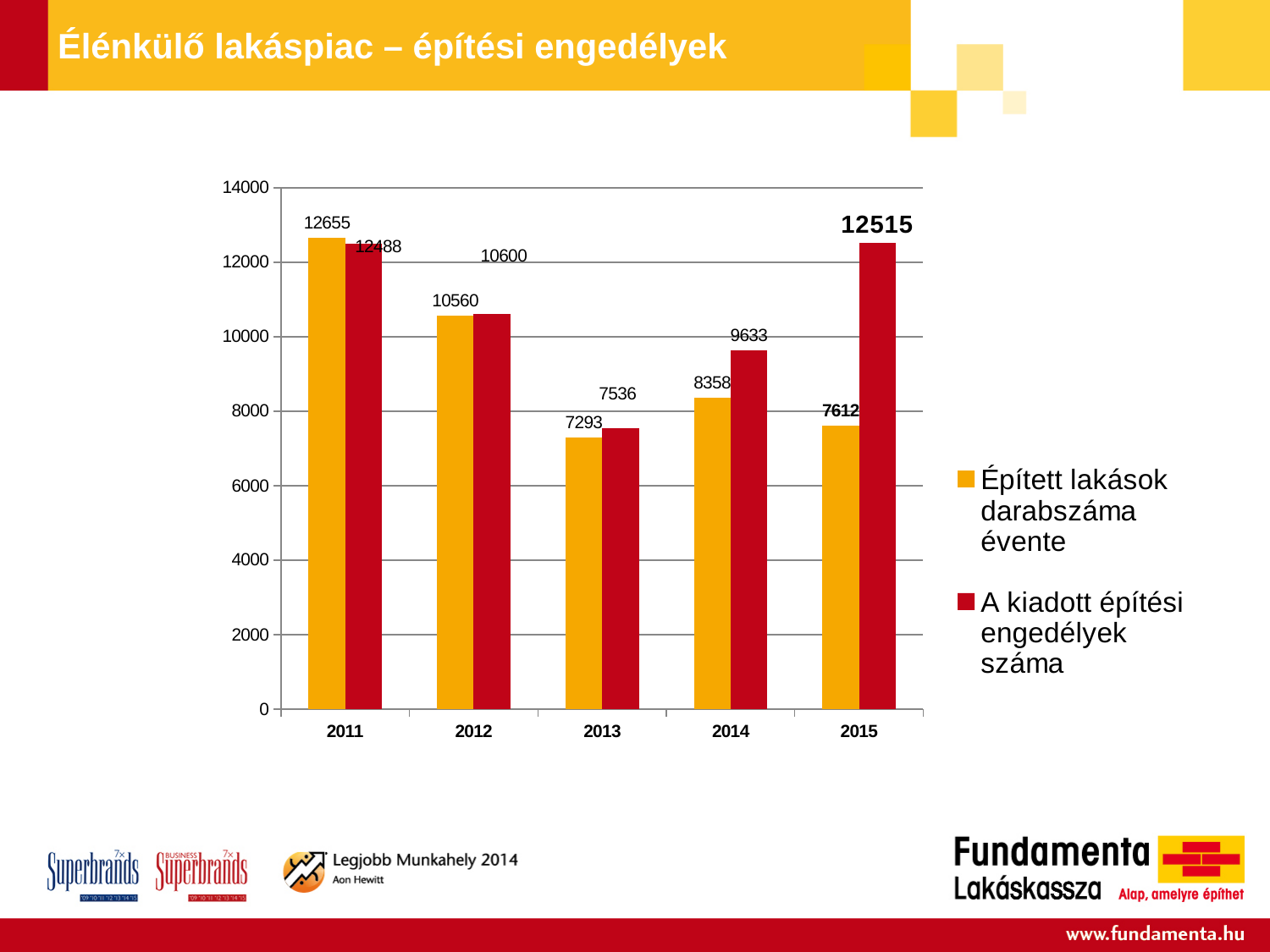
In which year is "A kiadott építési engedélyek száma" lowest? 2013 In which year is "Épített lakások darabszáma évente" lowest? 2013 In which year is "Épített lakások darabszáma évente" highest? 2011 How many series does the legend list? 2 What is the value of "Épített lakások darabszáma évente" for 2013? 7293 What is the difference between "A kiadott építési engedélyek száma" and "Épített lakások darabszáma évente" in 2015? 4903 Which is larger in 2014: "Épített lakások darabszáma évente" or "A kiadott építési engedélyek száma"? A kiadott építési engedélyek száma What is the value of "A kiadott építési engedélyek száma" for 2015? 12515 How many years are shown on the x axis? 5 What is the value of "A kiadott építési engedélyek száma" for 2014? 9633 What is the value of "Épített lakások darabszáma évente" for 2011? 12655 What kind of chart is shown on the slide? bar chart